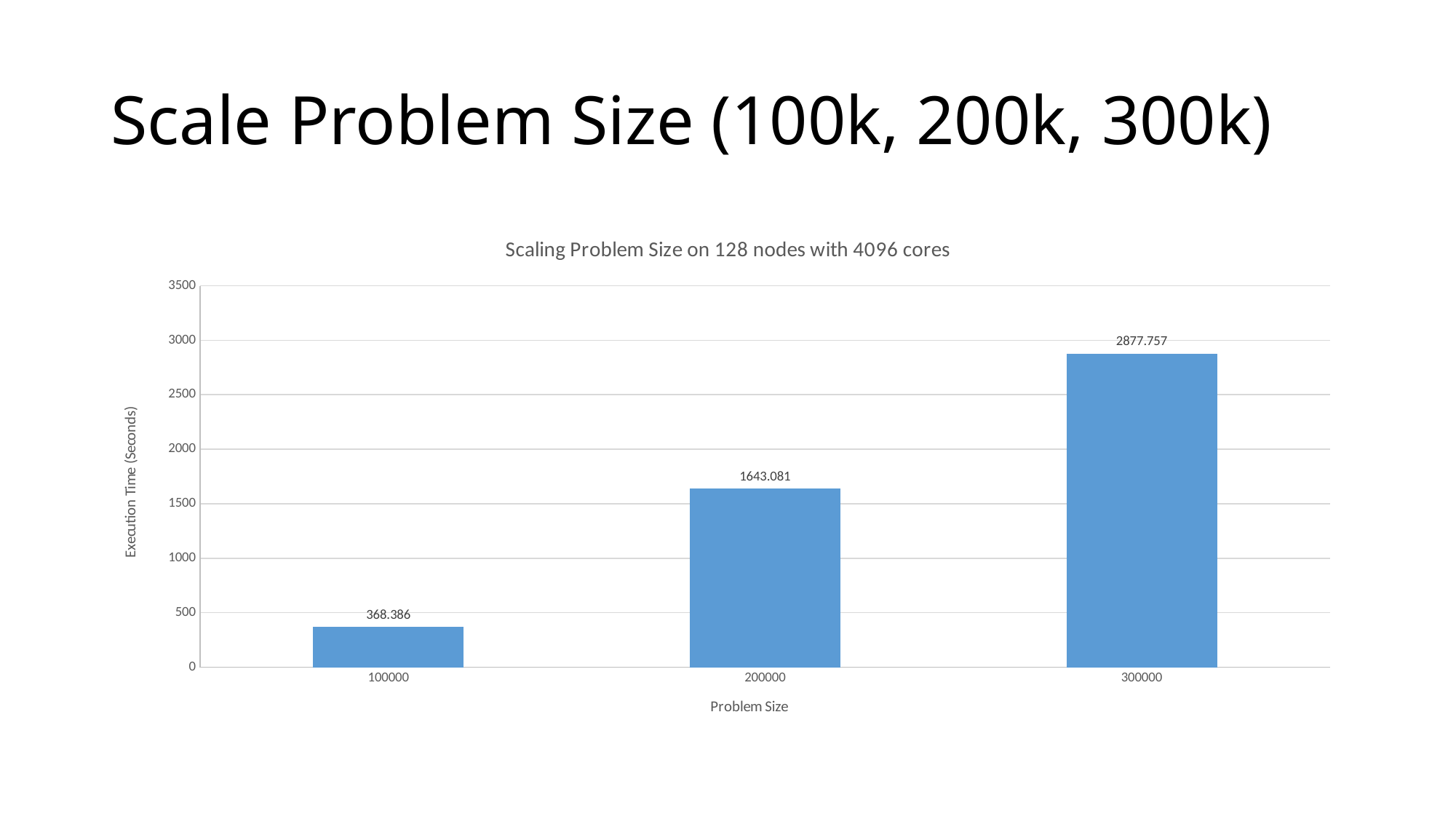
Which problem size has the highest execution time? 300000 What is the execution time for problem size 300000? 2877.757 What is the difference in execution time between problem size 300000 and problem size 200000? 1234.676 What type of chart is shown on the slide? bar chart Is the execution time for problem size 300000 greater or less than 2500? greater What is the execution time for problem size 200000? 1643.081 Does execution time rise or fall as problem size increases along the x axis? rise Which problem size has the lowest execution time? 100000 What is the difference in execution time between problem size 200000 and problem size 100000? 1274.695 How many problem sizes are plotted in the chart? 3 Which has a larger execution time, problem size 200000 or problem size 100000? 200000 What is the execution time for problem size 100000? 368.386